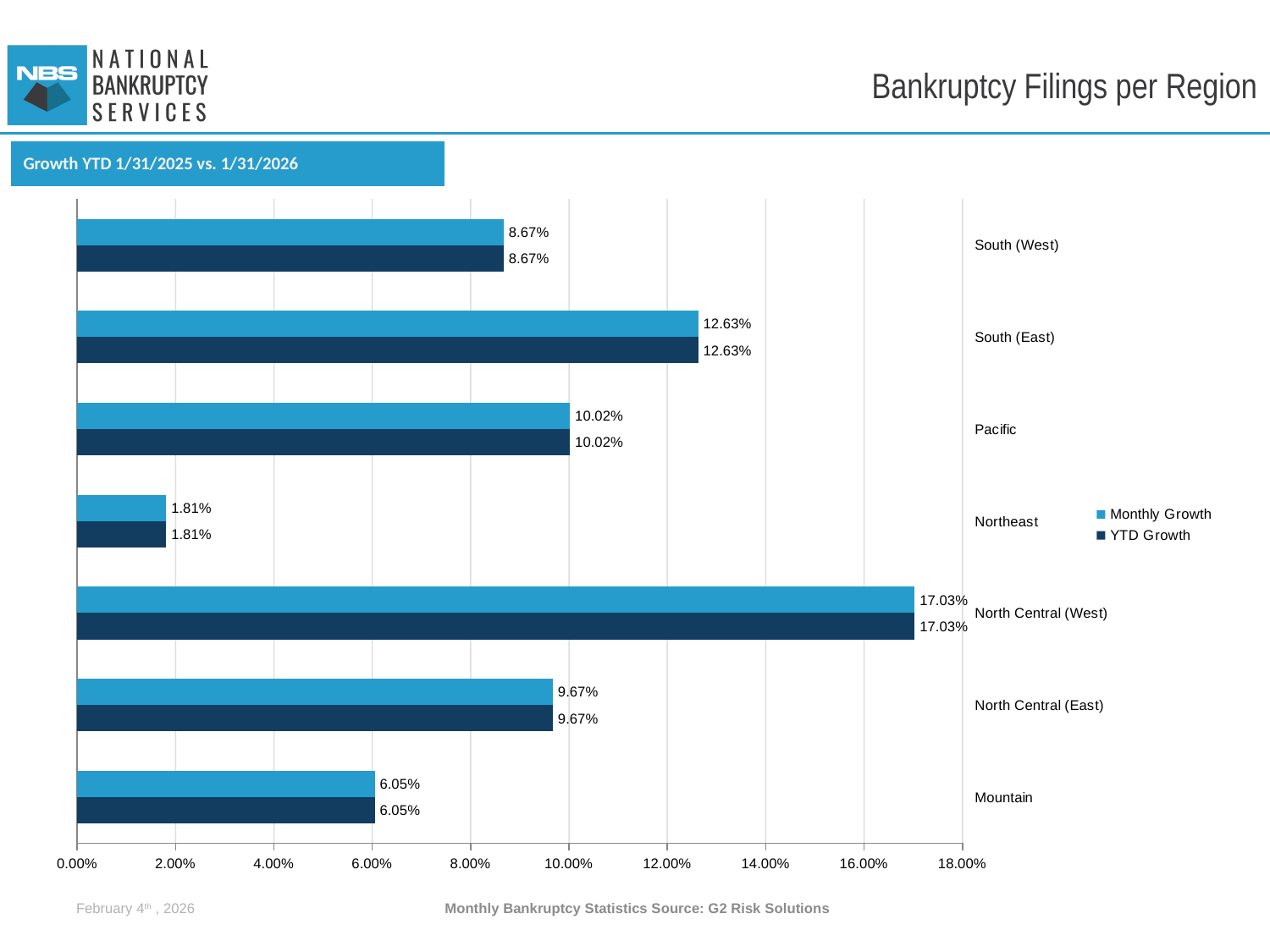
What is the YTD Growth value for Pacific? 10.02% What is the Monthly Growth value for Mountain? 6.05% How many regions are shown on the chart? 7 What kind of chart is shown on the slide? Bar chart What is the Monthly Growth value for North Central (West)? 17.03% How many series does the legend list? 2 What is the title of the chart? Growth YTD 1/31/2025 vs. 1/31/2026 Which region has the highest Monthly Growth? North Central (West) Is the Monthly Growth value for South (East) greater or less than 12.00%? greater Which has a larger YTD Growth, North Central (East) or Pacific? Pacific Which region has the lowest YTD Growth? Northeast What is the difference between the Monthly Growth for South (East) and South (West)? 3.96%